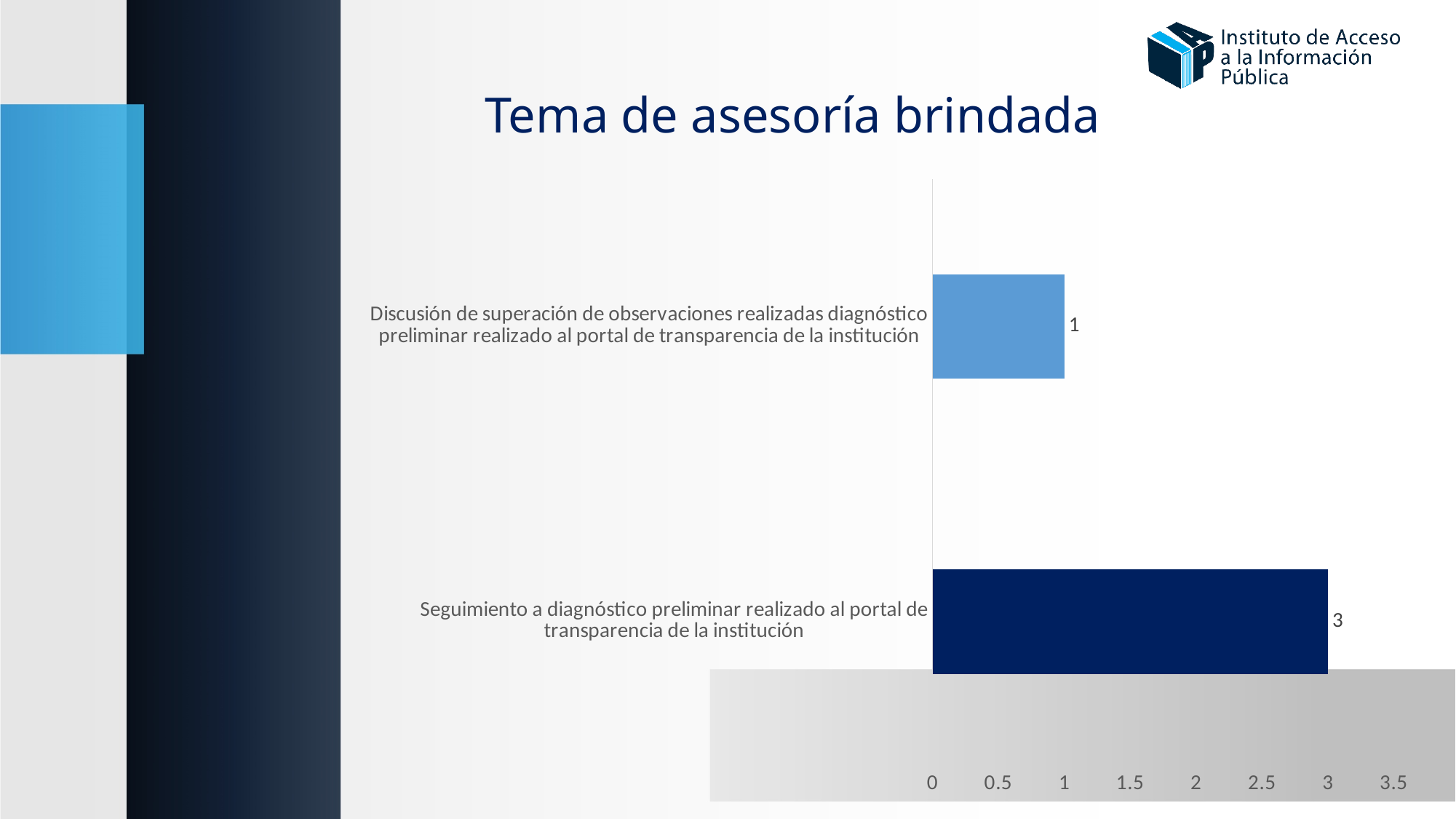
What is the title of the chart? Tema de asesoría brindada What is the value for "Discusión de superación de observaciones realizadas diagnóstico preliminar realizado al portal de transparencia de la institución"? 1 What is the value for "Seguimiento a diagnóstico preliminar realizado al portal de transparencia de la institución"? 3 What kind of chart is shown on the slide? Bar chart How many categories are shown in the chart? 2 Is the value for "Seguimiento a diagnóstico preliminar..." greater or less than 2? greater Which is larger: the value for "Seguimiento a diagnóstico preliminar..." or the value for "Discusión de superación de observaciones..."? Seguimiento a diagnóstico preliminar realizado al portal de transparencia de la institución What is the highest value shown on the x axis? 3.5 What is the difference between the value for "Seguimiento a diagnóstico preliminar..." and the value for "Discusión de superación de observaciones..."? 2 Is the value for "Discusión de superación de observaciones..." greater or less than 2? less Which category has the highest value? Seguimiento a diagnóstico preliminar realizado al portal de transparencia de la institución Which category has the lowest value? Discusión de superación de observaciones realizadas diagnóstico preliminar realizado al portal de transparencia de la institución